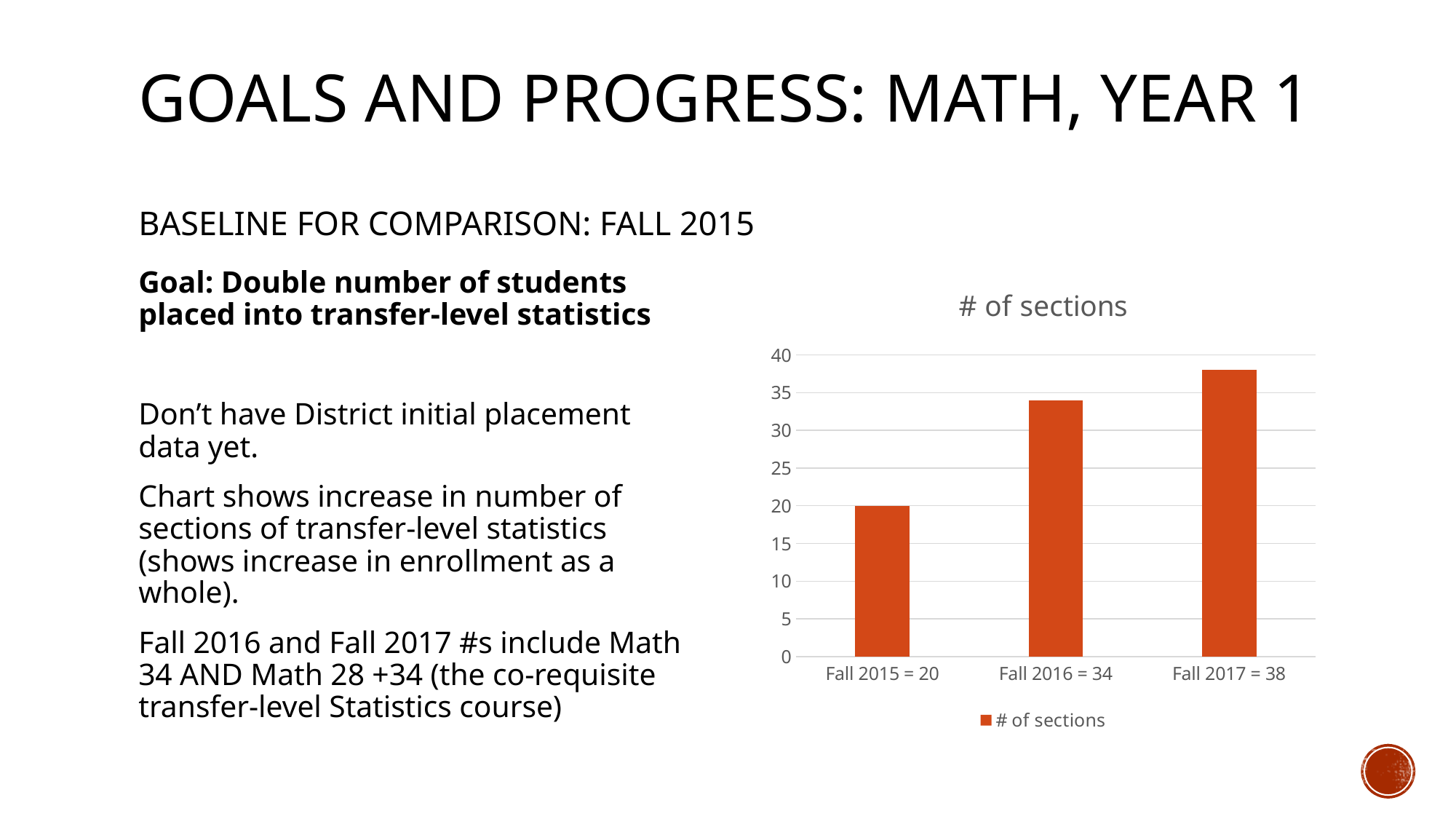
How many series does the chart legend list? 1 What is the number of sections for Fall 2015? 20 Which category has the highest number of sections? Fall 2017 What is the number of sections for Fall 2016? 34 Do the values rise or fall from Fall 2015 to Fall 2017? rise How many categories are plotted in the chart? 3 Which has more sections, Fall 2016 or Fall 2015? Fall 2016 Which category has the lowest number of sections? Fall 2015 What is the number of sections for Fall 2017? 38 What is the difference in number of sections between Fall 2017 and Fall 2015? 18 What type of chart is shown on the slide? bar chart What is the title of the chart? # of sections